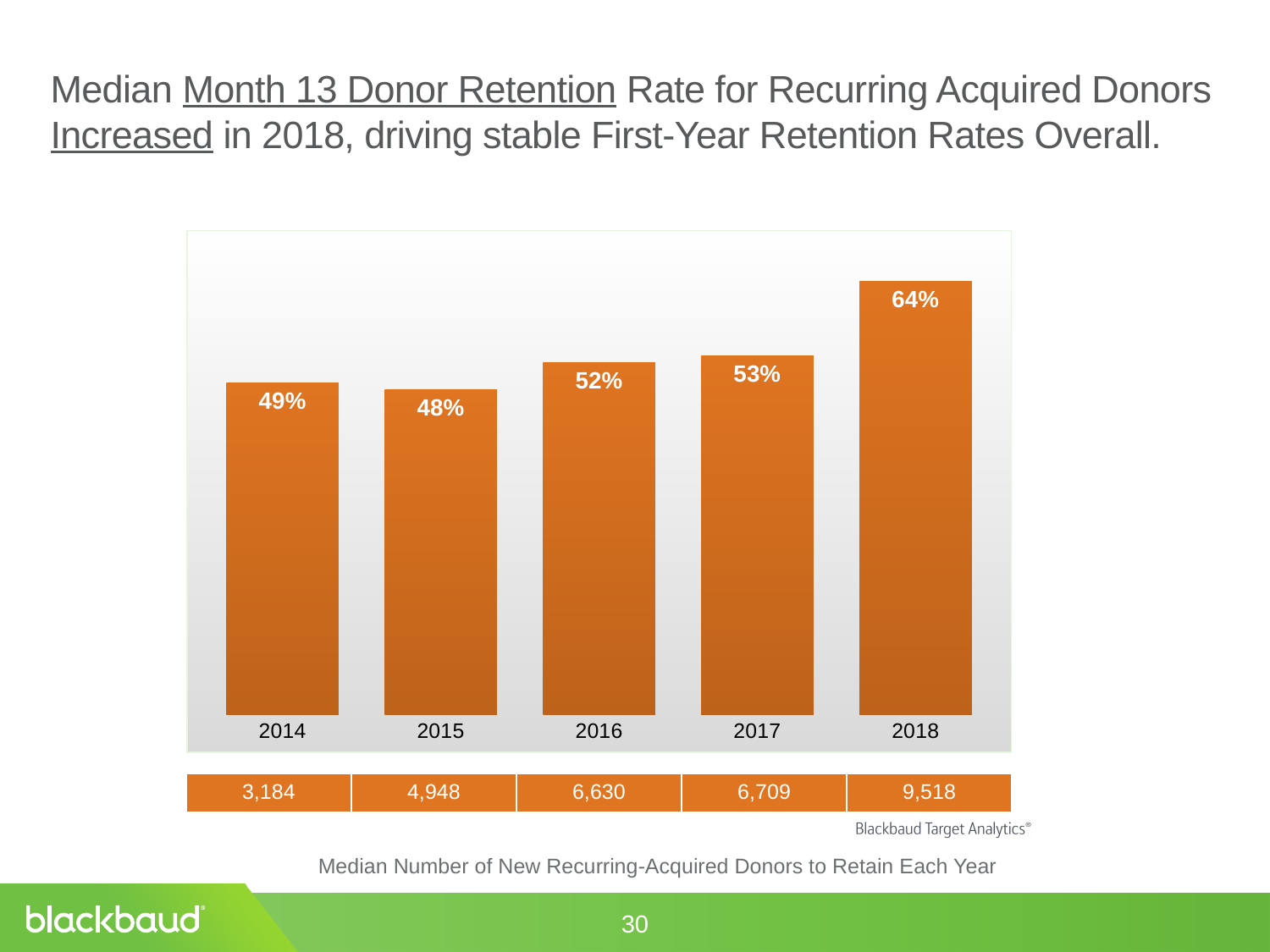
What is the median Month 13 donor retention rate for 2015? 48% What is the difference in retention rate between 2018 and 2017? 11% Which year has the highest median Month 13 donor retention rate? 2018 Which year has the lowest median Month 13 donor retention rate? 2015 What is the difference in retention rate between 2014 and 2015? 1% What is the median number of new recurring-acquired donors to retain shown below the chart for 2018? 9,518 Do the retention rates generally rise or fall from 2015 to 2018? Rise What is the median Month 13 donor retention rate for 2018? 64% What kind of chart is shown on the slide? Bar chart Which year has a higher retention rate, 2016 or 2018? 2018 How many years are shown on the chart? 5 What is the median Month 13 donor retention rate for 2016? 52%